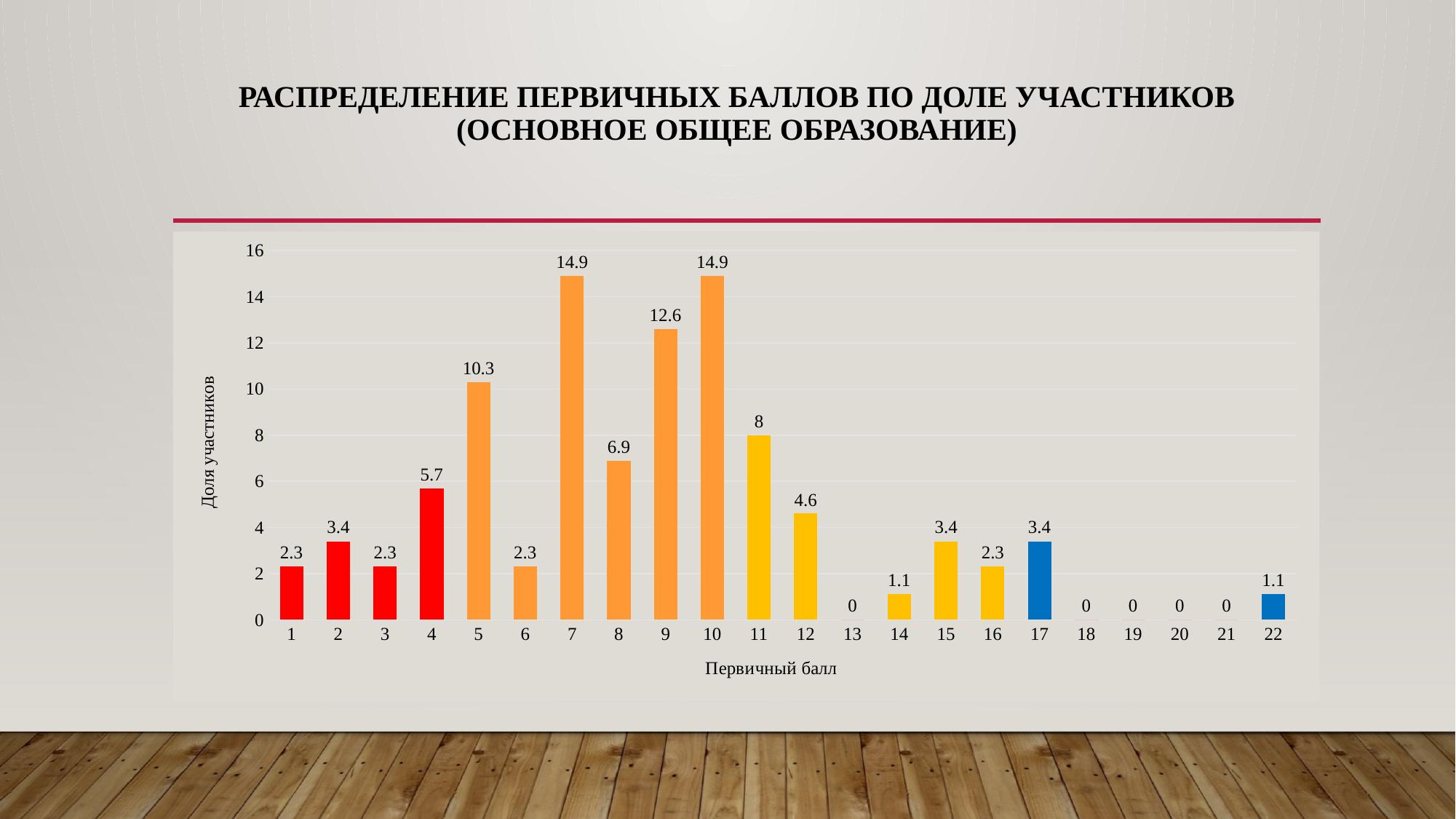
What is the difference between the share of participants for primary score 5 and primary score 8? 3.4 What is the difference between the share of participants for primary score 10 and primary score 9? 2.3 What is the share of participants for a primary score of 9? 12.6 What is the share of participants (Доля участников) for a primary score (Первичный балл) of 5? 10.3 Is the share of participants for primary score 9 greater or less than 12? greater What is the share of participants for a primary score of 11? 8 What is the share of participants for a primary score of 22? 1.1 What is the highest share of participants shown in the chart? 14.9 How many primary score categories have a share of participants equal to 0? 5 What kind of chart is shown on the slide? bar chart Which primary score has a larger share of participants, 11 or 12? 11 How many primary score categories are shown on the x axis? 22